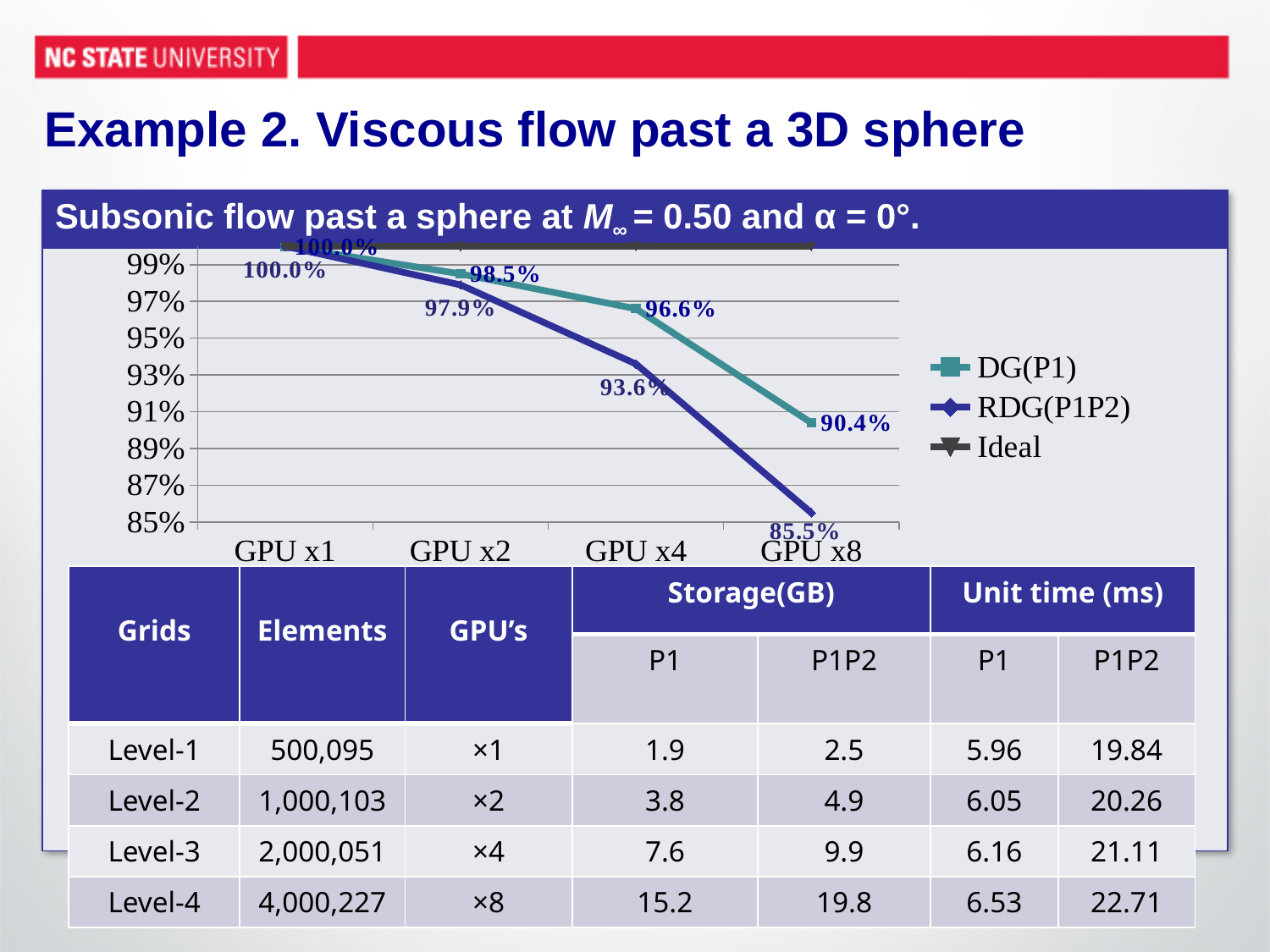
What kind of chart is shown on the slide? Line chart Is the Ideal value at GPU x8 greater or less than 99%? greater What is the value for DG(P1) at GPU x4? 96.6% What is the value for RDG(P1P2) at GPU x8? 85.5% How many GPU configurations are shown on the x axis? 4 What is the value for DG(P1) at GPU x8? 90.4% At GPU x8, how much higher is DG(P1) than RDG(P1P2)? 4.9 percentage points At GPU x4, which series has the higher value, DG(P1) or RDG(P1P2)? DG(P1) What is the value for RDG(P1P2) at GPU x2? 97.9% Does the RDG(P1P2) series rise or fall as the number of GPUs increases from x1 to x8? Falls At which GPU configuration is the RDG(P1P2) value lowest? GPU x8 How many series does the legend list? 3